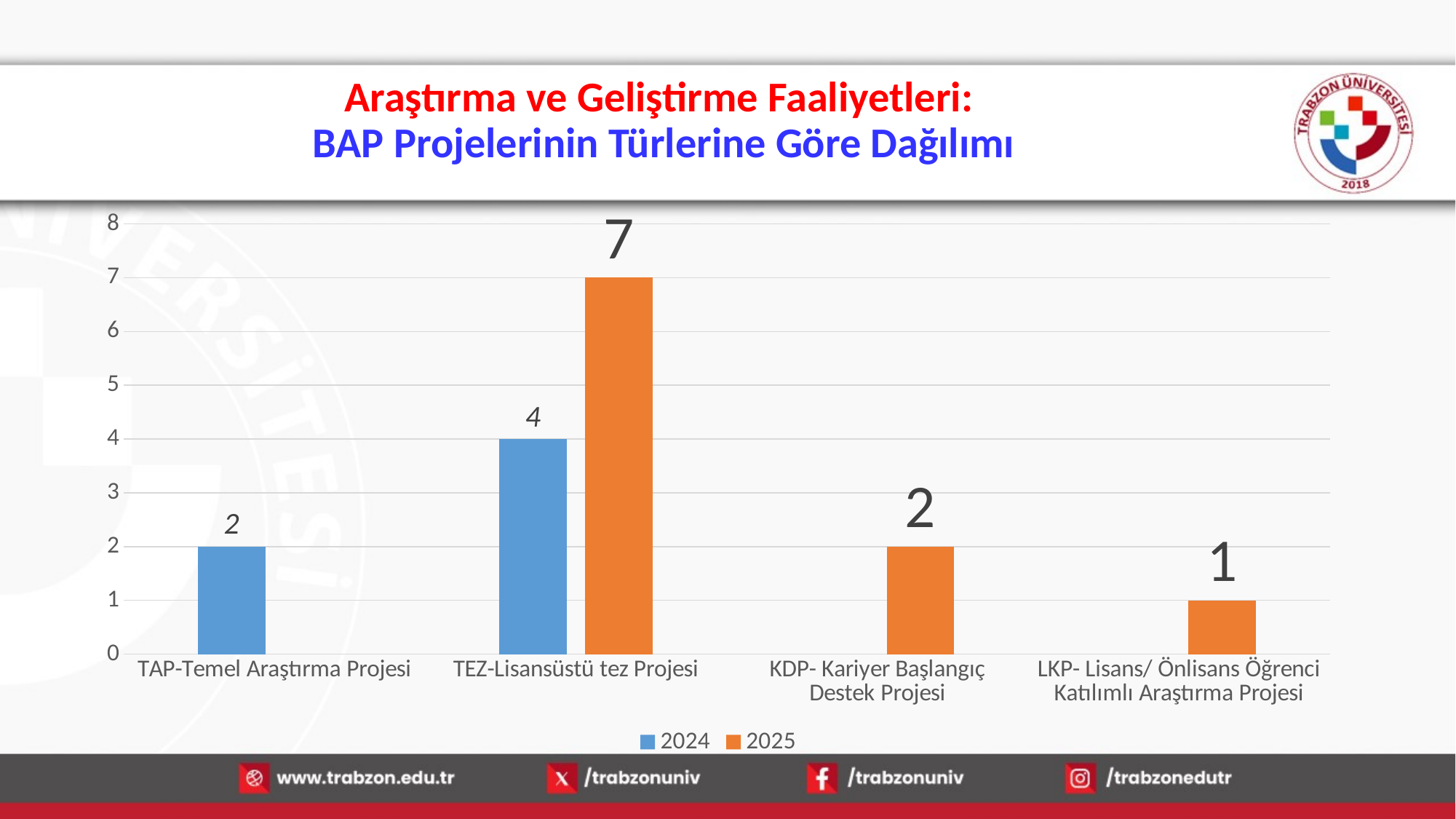
Which category has the highest 2025 value? TEZ-Lisansüstü tez Projesi How many categories are shown on the x axis? 4 What is the 2025 value for TEZ-Lisansüstü tez Projesi? 7 What is the 2025 value for LKP- Lisans/ Önlisans Öğrenci Katılımlı Araştırma Projesi? 1 Which series is shown in orange in the legend? 2025 What is the difference between the 2025 and 2024 values for TEZ-Lisansüstü tez Projesi? 3 What is the 2025 value for KDP- Kariyer Başlangıç Destek Projesi? 2 What is the 2024 value for TAP-Temel Araştırma Projesi? 2 What is the 2024 value for TEZ-Lisansüstü tez Projesi? 4 How many series does the legend list? 2 What kind of chart is shown on the slide? bar chart Which category has the lowest 2025 value? LKP- Lisans/ Önlisans Öğrenci Katılımlı Araştırma Projesi